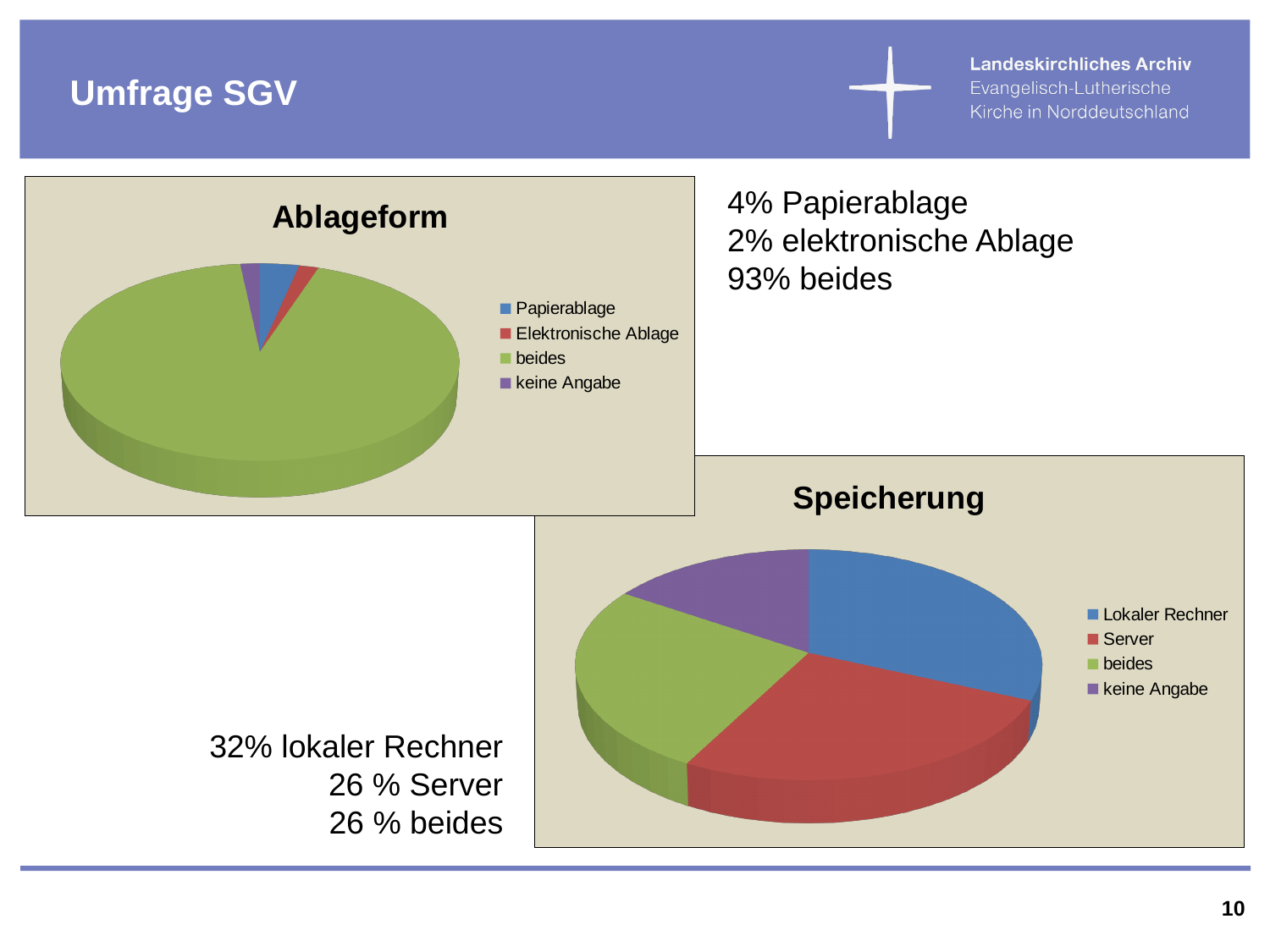
In the "Ablageform" chart, what share is given for "Papierablage"? 4% In the "Speicherung" chart, which category has the smallest slice? keine Angabe In the "Ablageform" chart, what share is given for "beides"? 93% How many entries does the legend of the "Speicherung" chart list? 4 What kind of chart is the "Ablageform" chart? pie chart In the "Ablageform" chart, which is larger: Papierablage or Elektronische Ablage? Papierablage In the "Speicherung" chart, which category has the largest slice? Lokaler Rechner In the "Speicherung" chart, what is the difference between the shares for lokaler Rechner and Server? 6 percentage points How many entries does the legend of the "Ablageform" chart list? 4 In the "Ablageform" chart, which category has the largest slice? beides In the "Speicherung" chart, what share is given for "Server"? 26 % In the "Ablageform" chart, what colour represents "beides"? green